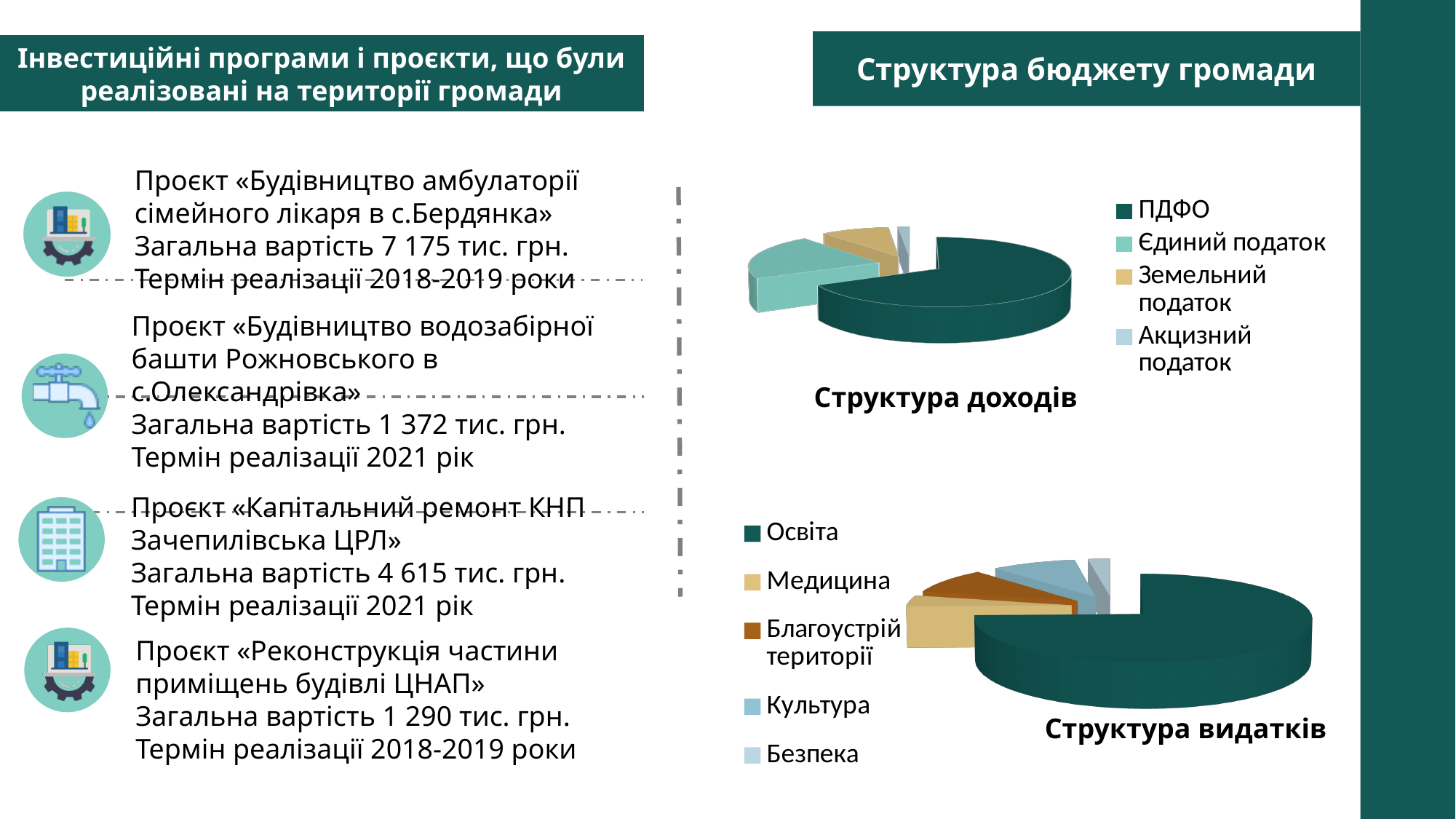
In the "Структура видатків" chart, which category has the largest slice? Освіта In the "Структура видатків" chart, which category has the smallest slice? Безпека What kind of chart is the "Структура видатків" chart? pie chart In the "Структура видатків" chart, which slice is larger: Культура or Безпека? Культура What kind of chart is the "Структура доходів" chart? pie chart In the "Структура доходів" chart, how many categories does the legend list? 4 In the "Структура видатків" chart, which legend entry is shown in brown? Благоустрій території In the "Структура доходів" chart, which slice is larger: Єдиний податок or Земельний податок? Єдиний податок In the "Структура видатків" chart, how many categories does the legend list? 5 In the "Структура доходів" chart, which category has the smallest slice? Акцизний податок What is the title of the section containing the two pie charts on the right of the slide? Структура бюджету громади In the "Структура доходів" chart, which category has the largest slice? ПДФО